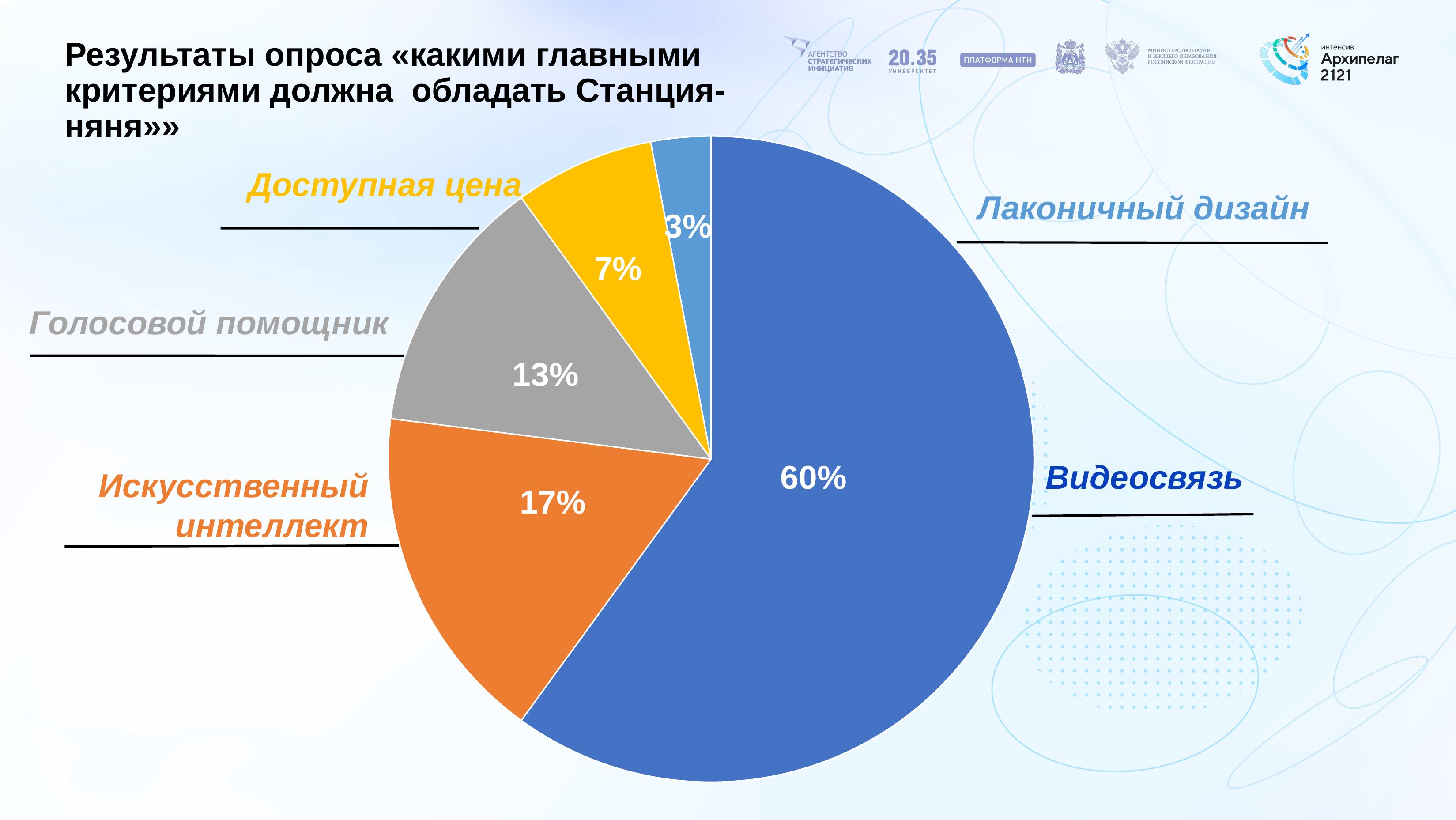
What kind of chart is shown on the slide? Pie chart What colour is the slice for Искусственный интеллект? Orange Which is larger, the value for Голосовой помощник or the value for Доступная цена? Голосовой помощник Which category has the smallest slice of the pie? Лаконичный дизайн What is the value for Голосовой помощник? 13% How many categories are shown in the pie chart? 5 What is the value for Доступная цена? 7% What share of the pie does Видеосвязь have? 60% Which category has the largest slice of the pie? Видеосвязь What is the value for Искусственный интеллект? 17% What is the difference between the values for Видеосвязь and Искусственный интеллект? 43% What is the value for Лаконичный дизайн? 3%